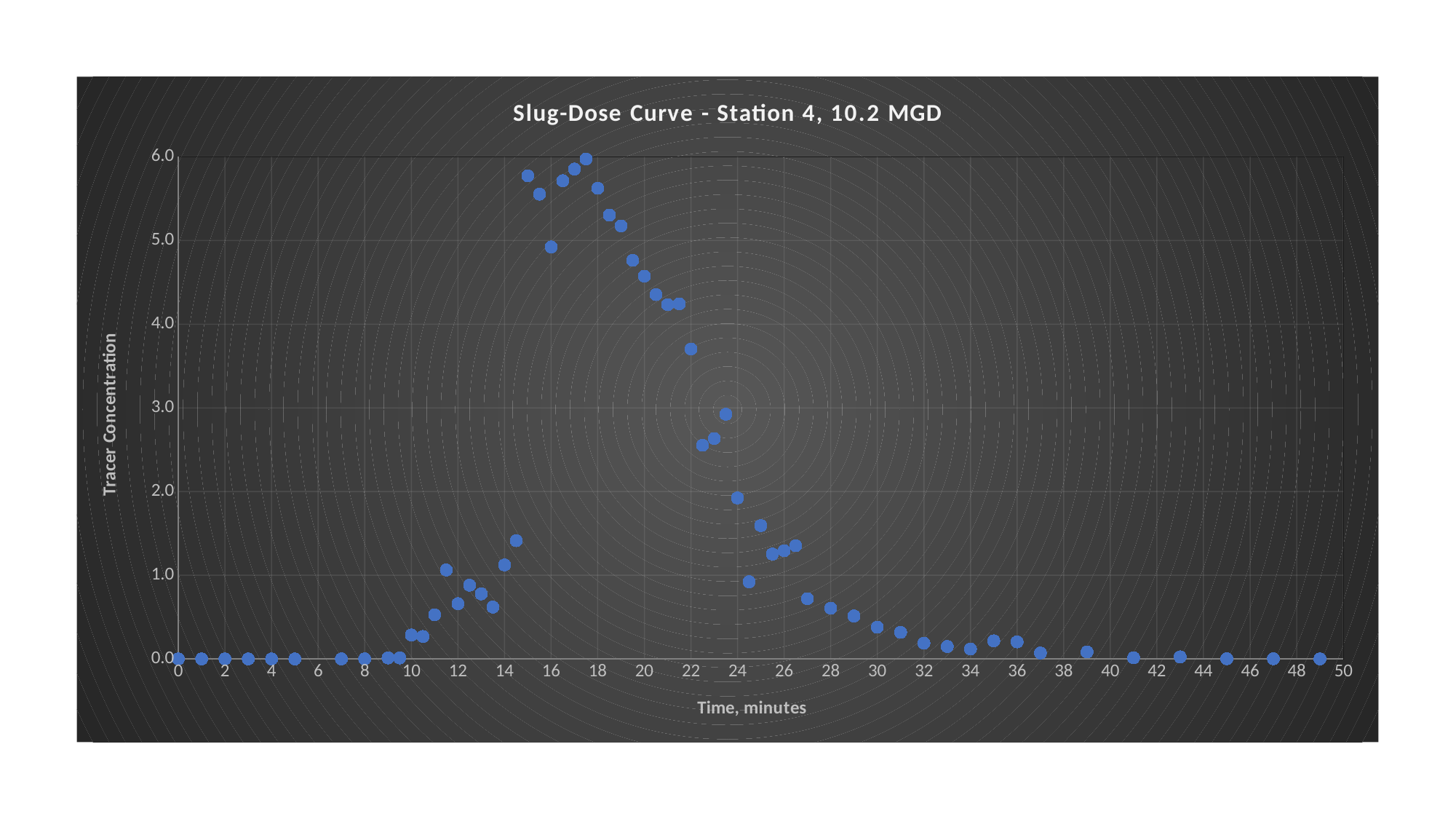
Is the tracer concentration at 15 minutes greater or less than 5.0? greater What kind of chart is shown on the slide? Scatter chart Is the tracer concentration at 30 minutes greater or less than 1.0? less Is the tracer concentration at 20 minutes greater or less than 4.0? greater Between which two labeled x-axis values does the highest tracer concentration occur? 16 and 18 Do the tracer concentration values rise or fall between 30 and 40 minutes? fall What is the tracer concentration at time 0 minutes? 0.0 Do the tracer concentration values rise or fall between 10 and 16 minutes? rise What is the label of the x axis? Time, minutes What is the title of the chart? Slug-Dose Curve - Station 4, 10.2 MGD Which is larger, the tracer concentration at 16 minutes or at 28 minutes? 16 minutes